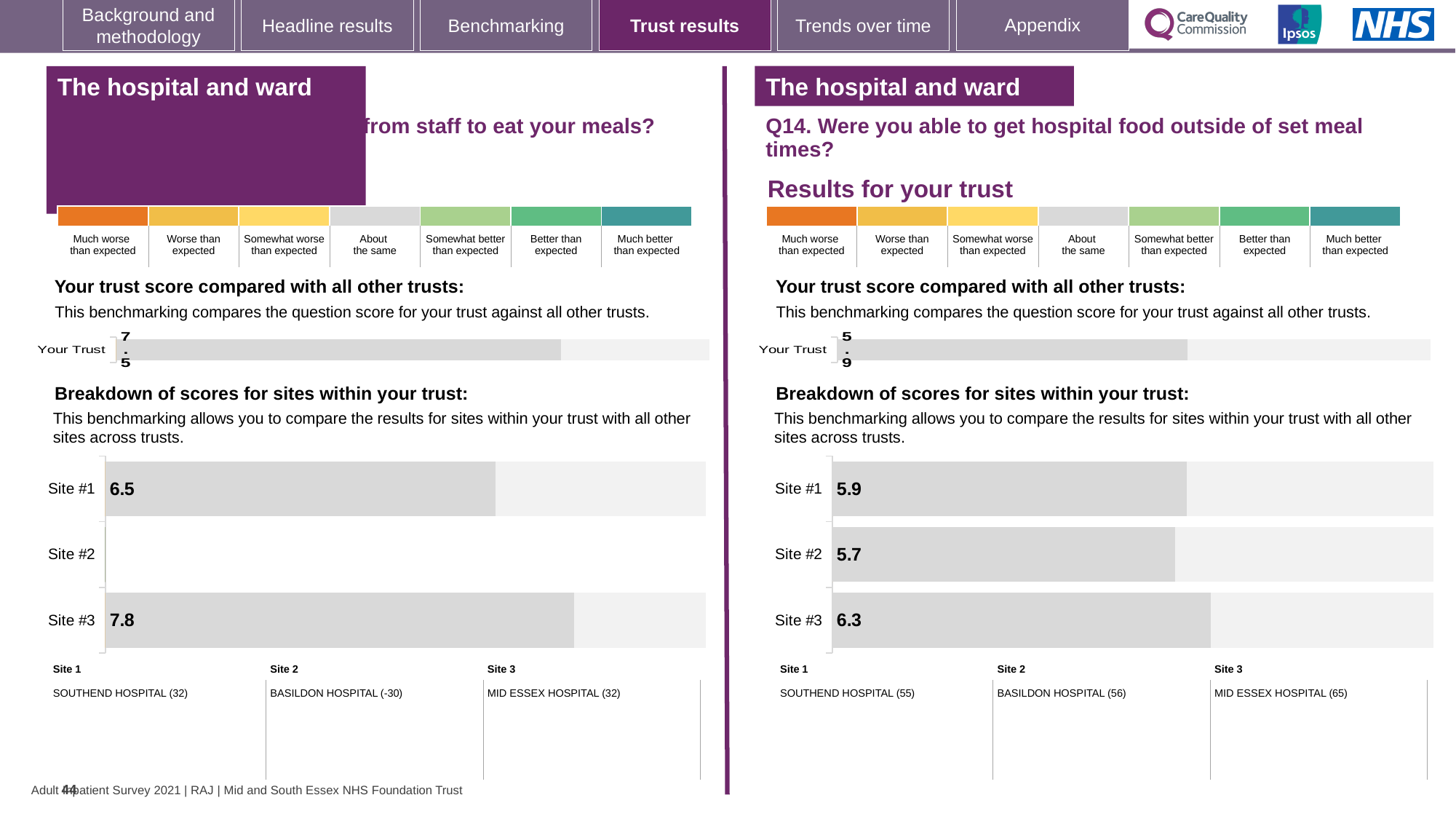
On the left-hand site breakdown chart, what is the score for Site #1? 6.5 What kind of chart is used for the site breakdown on the right-hand side of the slide? Bar chart On the right-hand chart for Q14, what is the score for Site #3? 6.3 On the right-hand 'Your trust score compared with all other trusts' chart for Q14, what is the score for Your Trust? 5.9 On the right-hand chart for Q14, what is the difference between the scores for Site #3 and Site #2? 0.6 On the right-hand chart for Q14 (hospital food outside of set meal times), what is the score for Site #1? 5.9 On the left-hand site breakdown chart, what is the difference between the scores for Site #3 and Site #1? 1.3 On the right-hand chart for Q14, which site has the highest score? Site #3 On the left-hand site breakdown chart, what is the score for Site #3? 7.8 On the right-hand chart for Q14, which site has the lowest score? Site #2 On the left-hand site breakdown chart, which of Site #1 and Site #3 has the higher score? Site #3 On the right-hand chart for Q14, what is the score for Site #2? 5.7